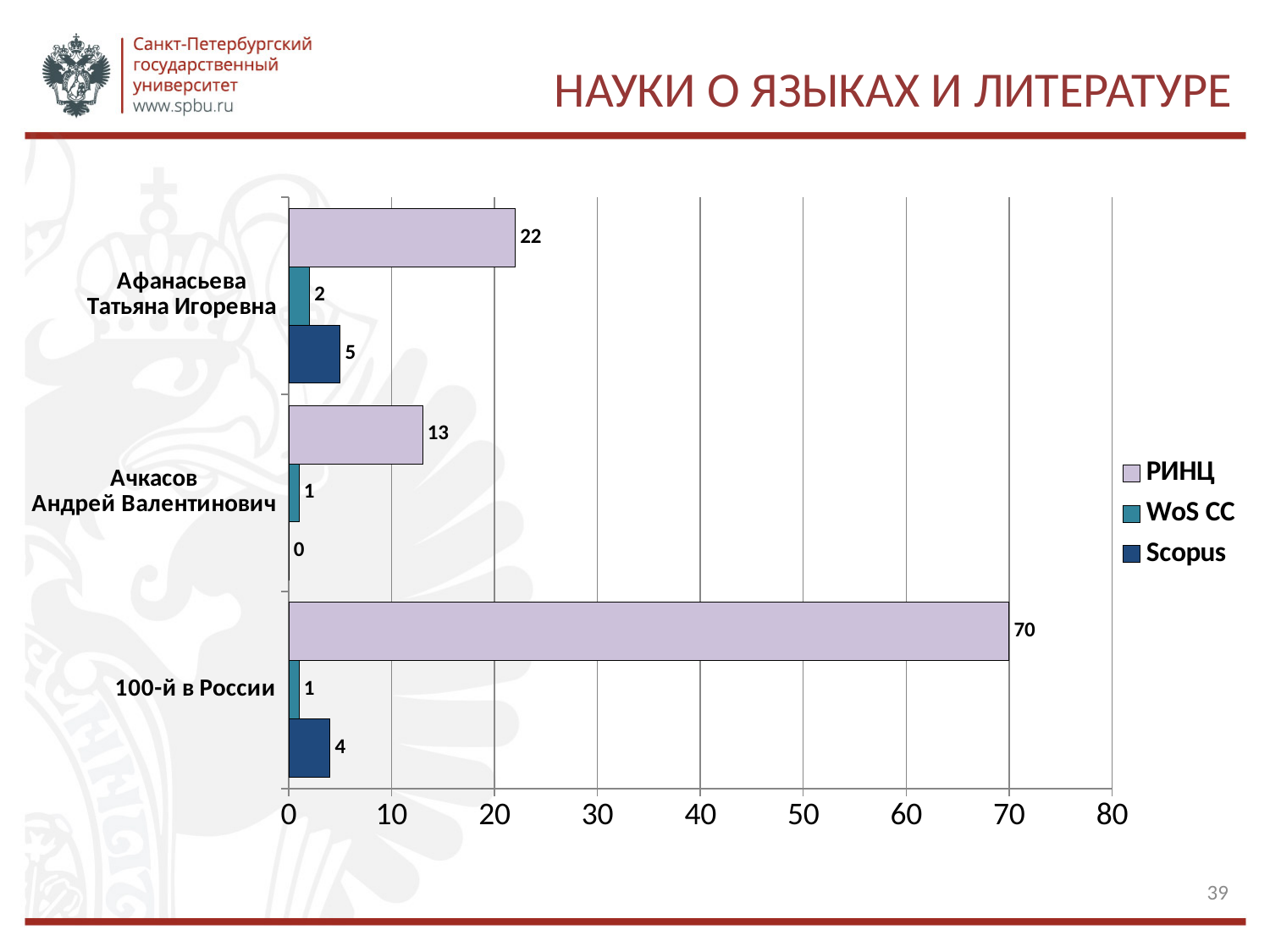
What is the РИНЦ value for Афанасьева Татьяна Игоревна? 22 What is the WoS CC value for 100-й в России? 1 What is the difference between the РИНЦ values for 100-й в России and Афанасьева Татьяна Игоревна? 48 What is the title of the slide? НАУКИ О ЯЗЫКАХ И ЛИТЕРАТУРЕ How many series does the legend list? 3 What kind of chart is shown on the slide? bar chart Which category has the highest РИНЦ value? 100-й в России What is the Scopus value for Ачкасов Андрей Валентинович? 0 Which is larger: the Scopus value for Афанасьева Татьяна Игоревна or the Scopus value for 100-й в России? Афанасьева Татьяна Игоревна Which category has the lowest Scopus value? Ачкасов Андрей Валентинович Is the РИНЦ value for Ачкасов Андрей Валентинович greater or less than 20? less How many categories are shown on the y axis? 3